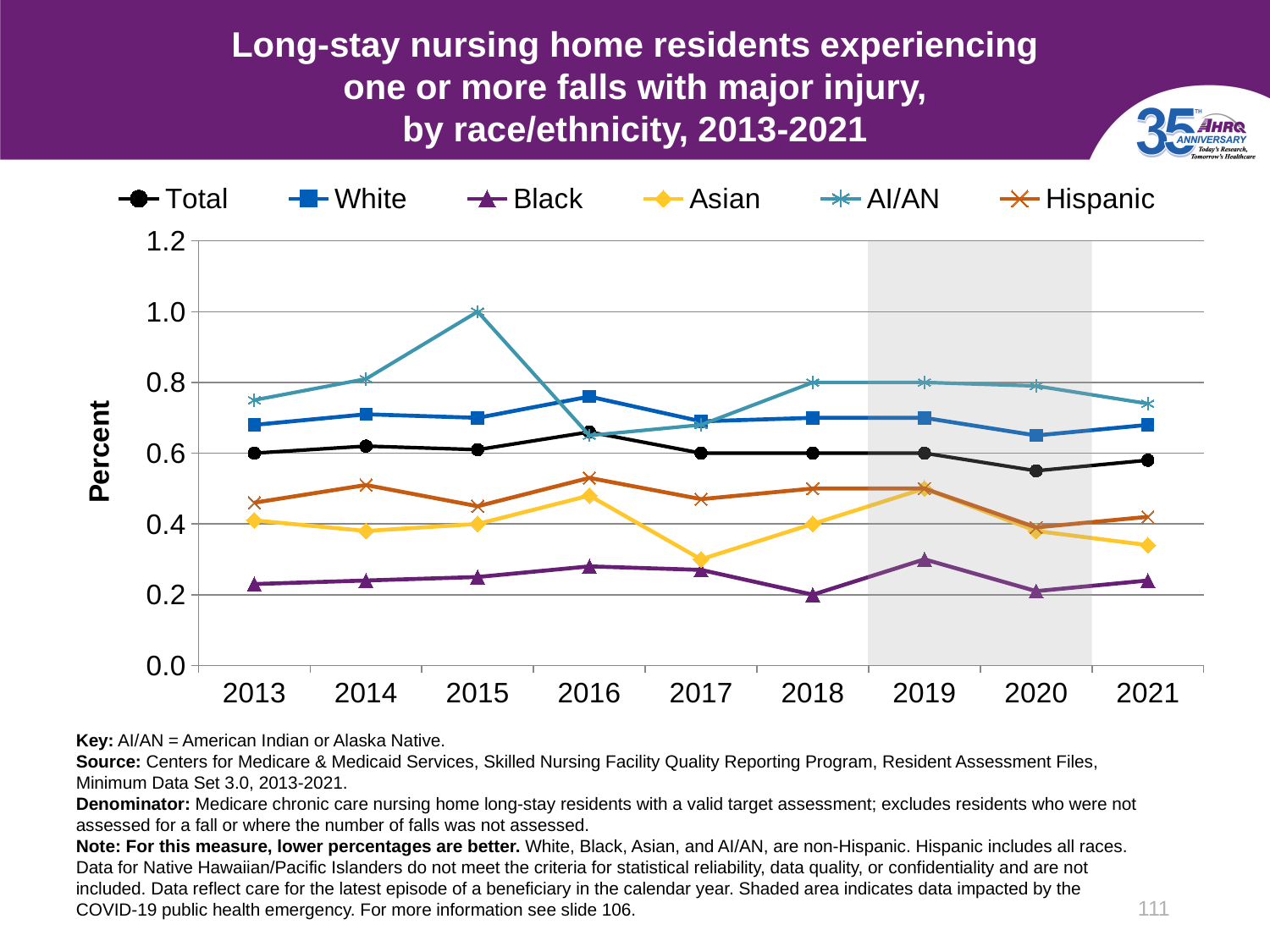
Is the value for Asian in 2017 greater or less than 0.4? less In which year does the AI/AN line reach its highest value? 2015 Does the AI/AN line rise or fall from 2013 to 2015? Rise What is the value for AI/AN in 2015? 1.0 Is the value for Black in 2013 greater or less than 0.4? less How many years are plotted along the x axis? 9 What kind of chart is shown on the slide? Line chart Which race/ethnicity group has the highest value in 2015? AI/AN In 2016, which is larger, the value for White or the value for Total? White How many series does the legend list? 6 Which race/ethnicity group has the lowest value in 2018? Black Is the value for White in 2016 greater or less than 0.6? greater